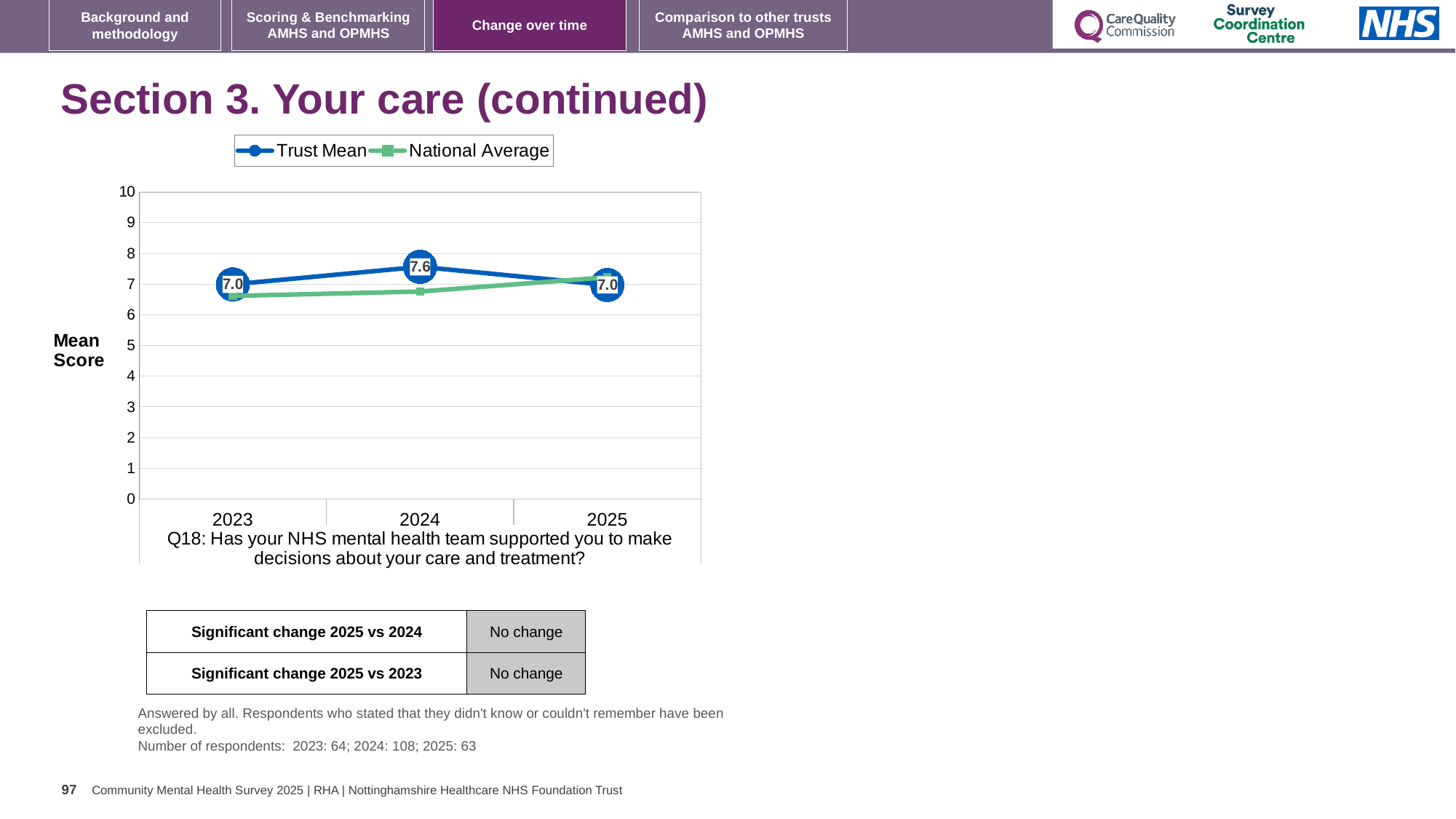
Which is larger, the Trust Mean in 2024 or the Trust Mean in 2025? 2024 What is the Trust Mean score for 2025? 7.0 How many years are plotted on the x axis? 3 How many series does the legend list? 2 What is the Trust Mean score for 2023? 7.0 What is the Trust Mean score for 2024? 7.6 Is the National Average value for 2023 greater or less than 7? less Is the National Average value for 2024 greater or less than 7? less What is the difference between the Trust Mean in 2024 and in 2023? 0.6 Does the Trust Mean rise or fall from 2024 to 2025? fall In which year is the Trust Mean highest? 2024 What kind of chart is shown on the slide? line chart